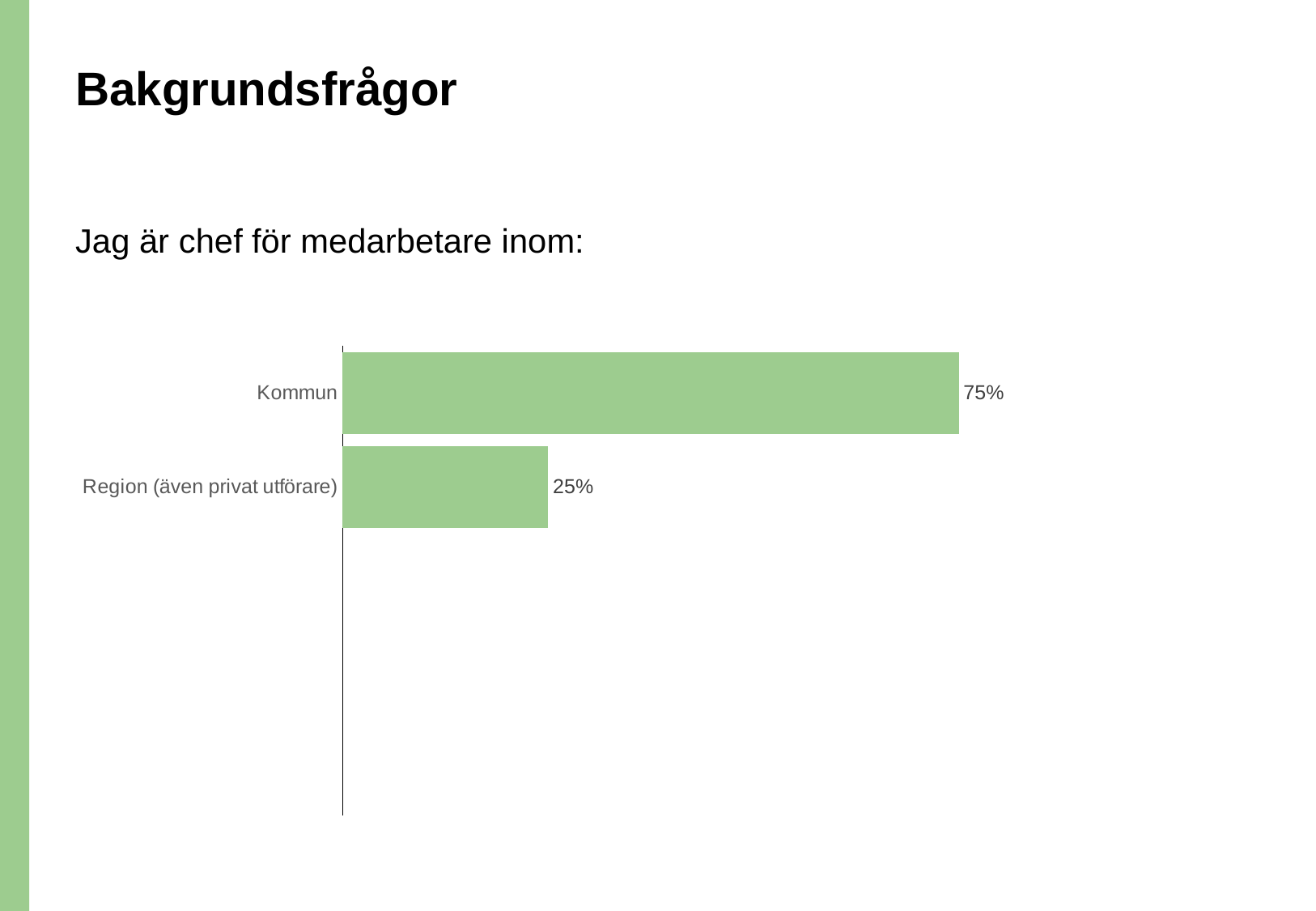
Which category has the highest value? Kommun What kind of chart is shown on the slide? Bar chart What is the value for Kommun? 75% What question does the chart answer, according to the text above it? Jag är chef för medarbetare inom: What is the total of the two values shown in the chart? 100% What colour are the bars in the chart? Green How many categories are shown in the chart? 2 What is the difference between the values for Kommun and Region (även privat utförare)? 50% Which category has the lowest value? Region (även privat utförare) What is the value for Region (även privat utförare)? 25% Which is larger, the value for Kommun or the value for Region (även privat utförare)? Kommun